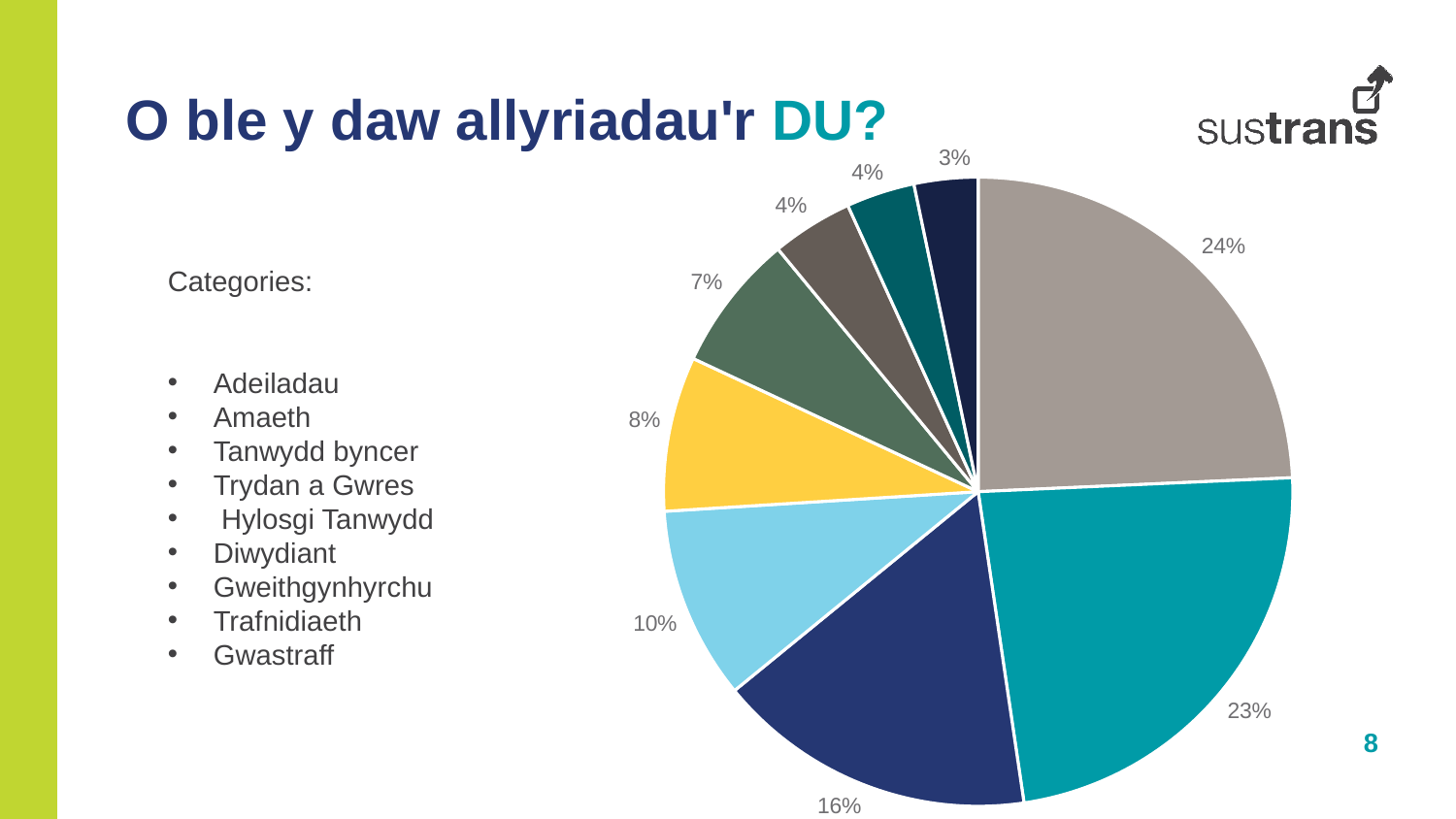
What is the percentage of the largest slice in the pie chart? 24% How many slices does the pie chart have? 9 Which is larger, the grey slice or the teal slice? the grey slice (24%) What percentage is shown for the yellow slice of the pie chart? 8% What is the difference between the largest slice (24%) and the second largest slice (23%)? 1% What is the title of the slide containing the pie chart? O ble y daw allyriadau'r DU? How many slices in the pie chart are labelled 4%? 2 What percentage is shown for the light blue slice of the pie chart? 10% What is the difference between the 16% slice and the 10% slice? 6% What kind of chart is shown on the slide? pie chart What percentage is shown for the dark navy slice at the bottom of the pie chart? 16% What is the percentage of the smallest slice in the pie chart? 3%